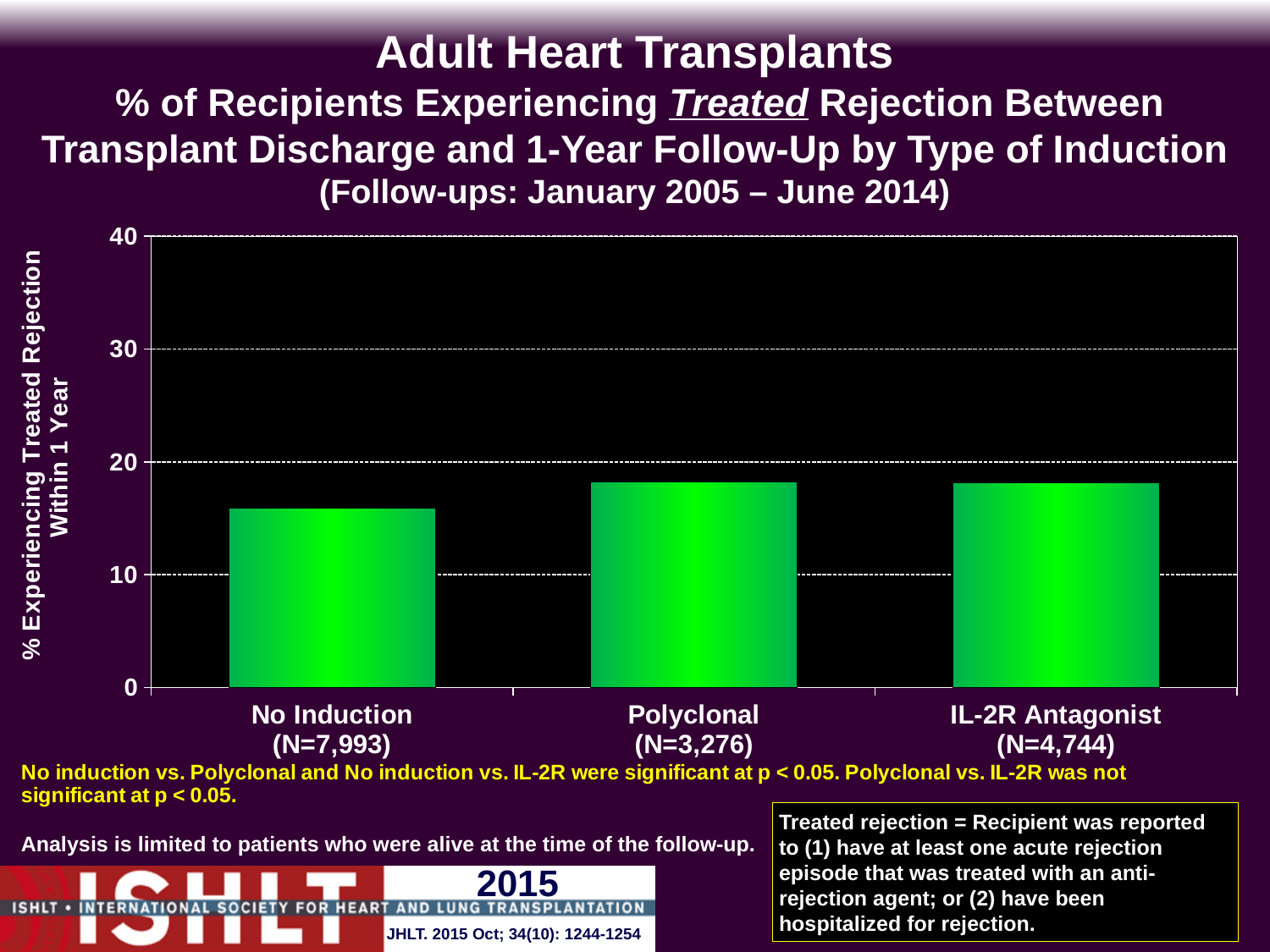
What is the label of the y-axis? % Experiencing Treated Rejection Within 1 Year What is the sample size (N) shown for the Polyclonal group? N=3,276 Which is larger, the value for No Induction or the value for Polyclonal? Polyclonal Is the value for IL-2R Antagonist greater or less than 10? greater How many induction types (bars) are shown in the chart? 3 Is the value for No Induction greater or less than 20? less Is the value for No Induction greater or less than 10? greater Which is larger, the value for No Induction or the value for IL-2R Antagonist? IL-2R Antagonist Which induction type has the lowest % experiencing treated rejection within 1 year? No Induction What kind of chart is shown on the slide? bar chart